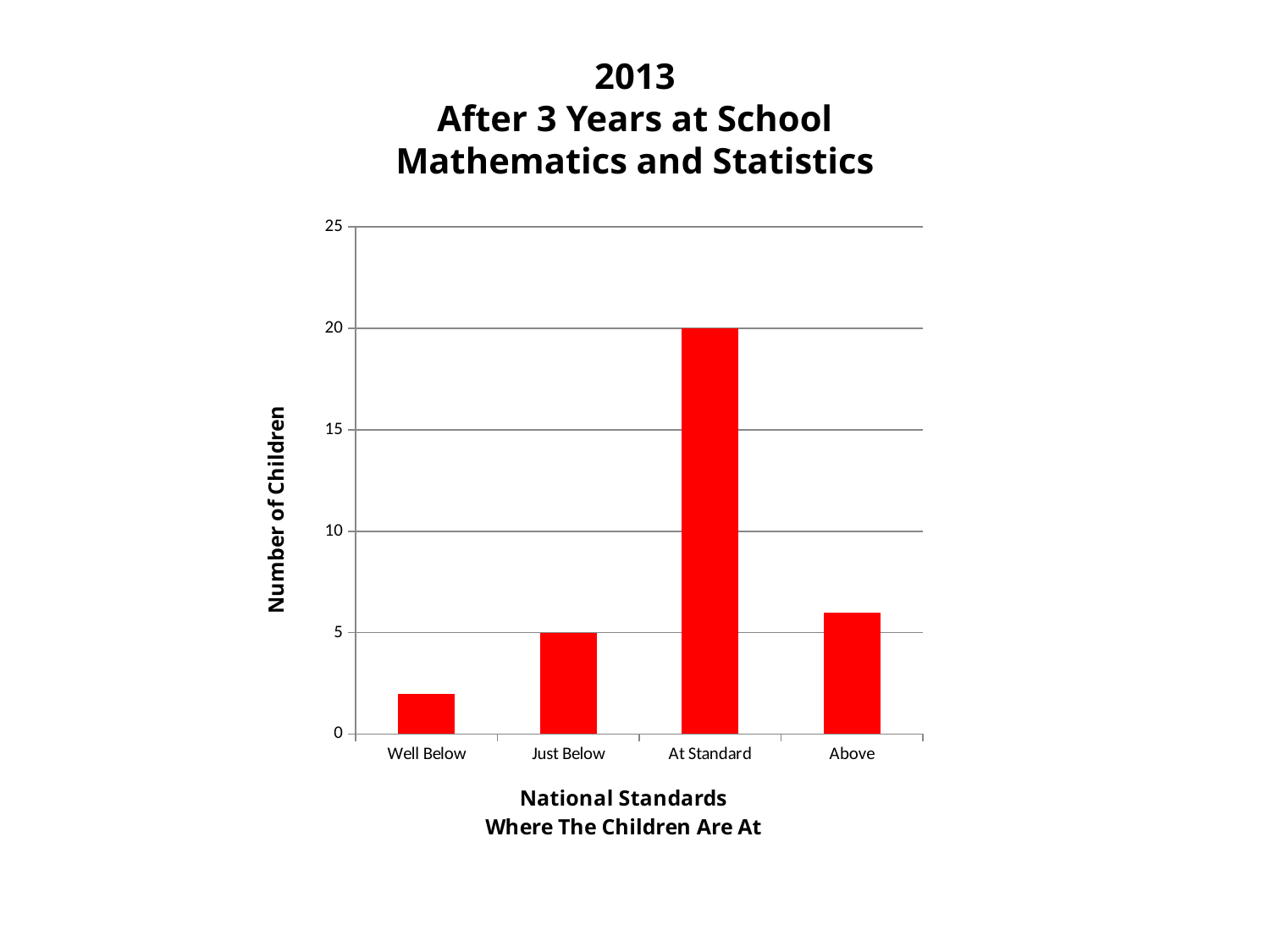
What type of chart is shown on the slide? bar chart Which category has the lowest number of children? Well Below What is the number of children for At Standard? 20 How many categories are shown on the x axis? 4 Is the value for Well Below greater or less than 5? less Which is larger, the value for Above or the value for Well Below? Above Is the value for Above greater or less than 5? greater What year is given in the chart title? 2013 Which category has the highest number of children? At Standard What is the difference between the number of children At Standard and Just Below? 15 What is the label of the y axis? Number of Children What is the number of children for Just Below? 5